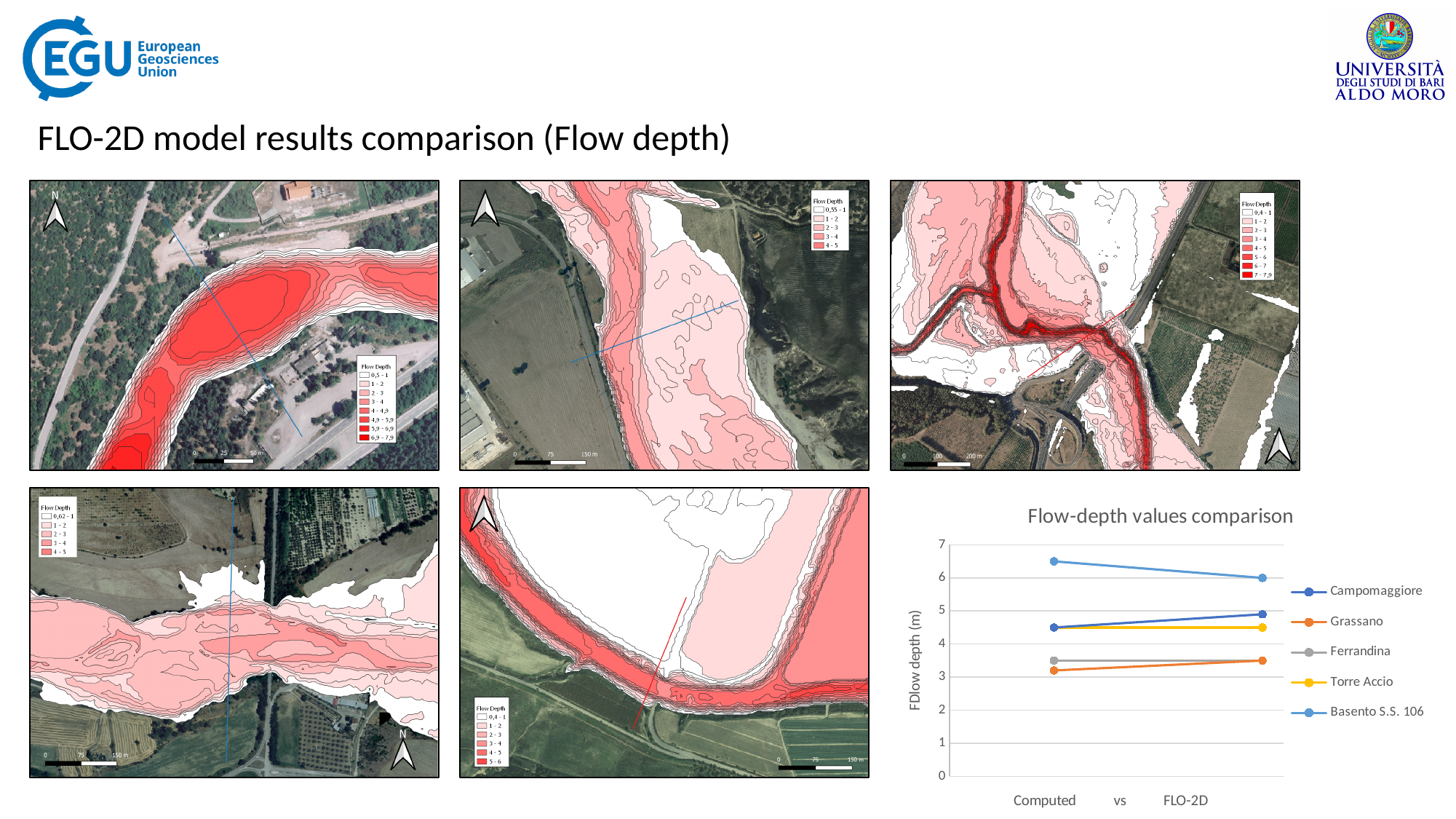
How many categories are shown on the x axis of the 'Flow-depth values comparison' chart? 2 In the 'Flow-depth values comparison' chart, which is larger at 'FLO-2D': Campomaggiore or Torre Accio? Campomaggiore In the 'Flow-depth values comparison' chart, does the Basento S.S. 106 series rise or fall from 'Computed' to 'FLO-2D'? fall In the 'Flow-depth values comparison' chart, is the 'FLO-2D' value for Campomaggiore greater or less than 4? greater In the 'Flow-depth values comparison' chart, does the Campomaggiore series rise or fall from 'Computed' to 'FLO-2D'? rise In the 'Flow-depth values comparison' chart, which series has the highest value at 'Computed'? Basento S.S. 106 How many series does the legend of the 'Flow-depth values comparison' chart list? 5 In the 'Flow-depth values comparison' chart, which series has the lowest value at 'Computed'? Grassano What is the title of the line chart on the right of the slide? Flow-depth values comparison What kind of chart is the 'Flow-depth values comparison' chart? line chart In the 'Flow-depth values comparison' chart, is the 'Computed' value for Grassano greater or less than 4? less In the 'Flow-depth values comparison' chart, is the 'Computed' value for Basento S.S. 106 greater or less than 6? greater